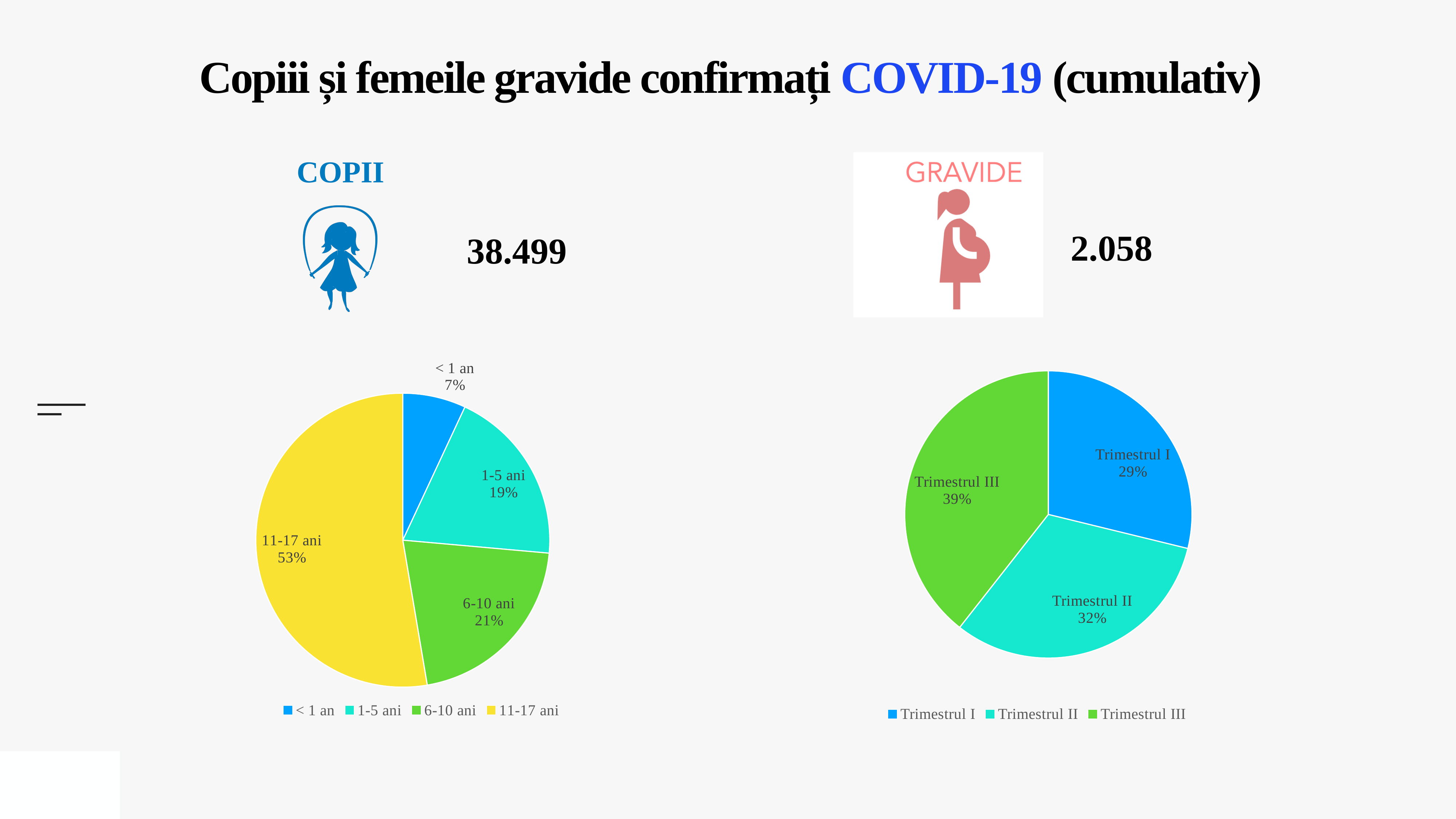
How many slices does the left pie chart (COPII) have? 4 In the left pie chart (COPII), what is the difference in percentage points between the 6-10 ani and 1-5 ani slices? 2 What type of chart is used on the right side of the slide (GRAVIDE)? Pie chart In the right pie chart (GRAVIDE), what is the difference in percentage points between Trimestrul III and Trimestrul I? 10 In the right pie chart (GRAVIDE), which trimester has the largest share? Trimestrul III How many entries does the legend of the right pie chart (GRAVIDE) list? 3 In the right pie chart (GRAVIDE), which trimester has the smallest share? Trimestrul I In the right pie chart (GRAVIDE), what share is shown for Trimestrul II? 32% In the left pie chart (COPII), which age group has the smallest share? < 1 an In the left pie chart (COPII), what share is shown for the < 1 an slice? 7% In the left pie chart (COPII), which age group has the largest share? 11-17 ani In the left pie chart (COPII), what share is shown for the 11-17 ani slice? 53%